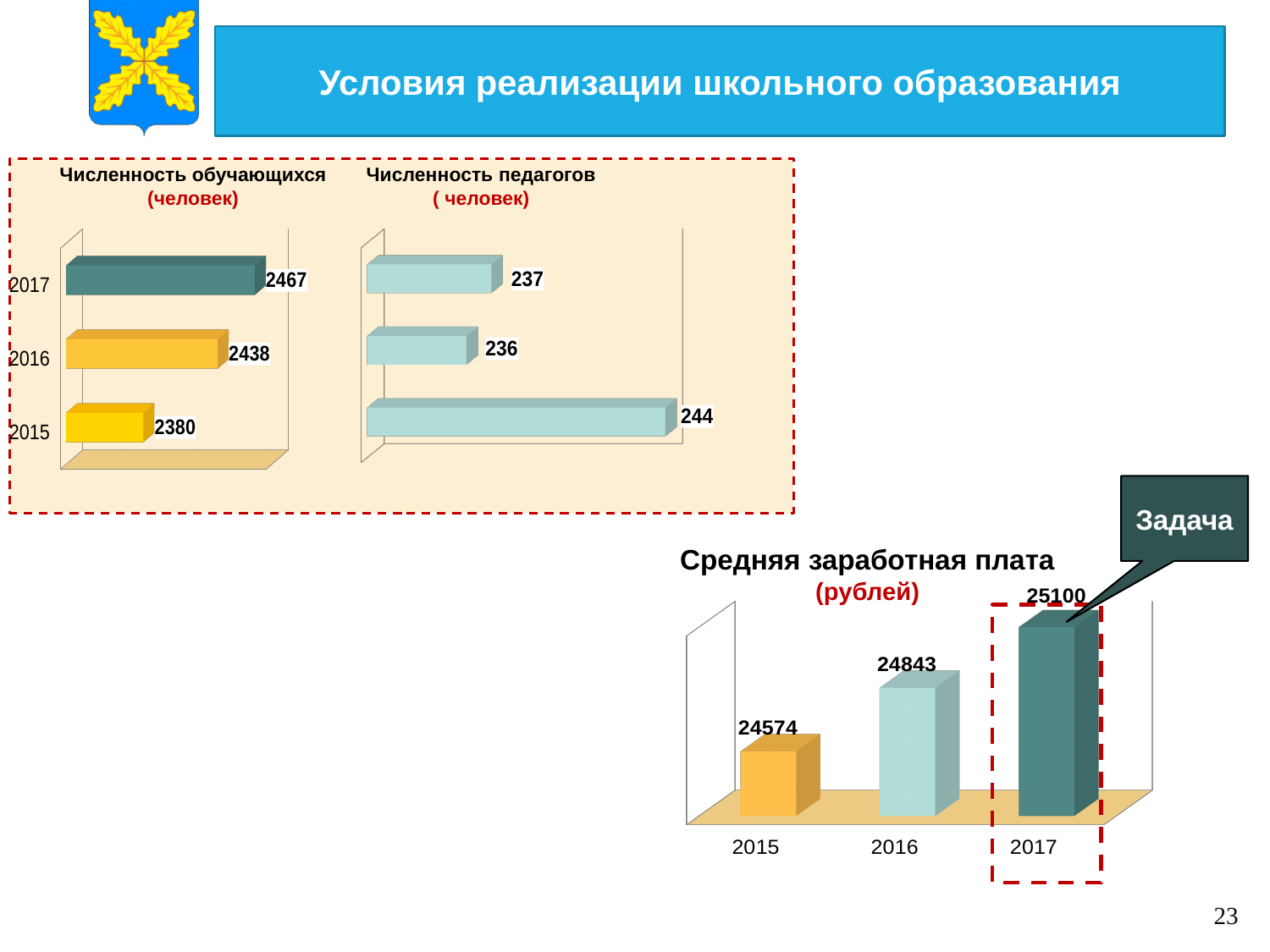
In the chart 'Численность обучающихся (человек)', what is the value for 2017? 2467 In the chart 'Численность педагогов (человек)', what is the value of the shortest bar? 236 In the chart 'Средняя заработная плата (рублей)', what is the difference between the 2017 and 2015 values? 526 In the chart 'Средняя заработная плата (рублей)', what is the value for 2016? 24843 In the chart 'Численность педагогов (человек)', what is the value of the longest bar? 244 In the chart 'Средняя заработная плата (рублей)', which year has the highest value? 2017 In the chart 'Численность обучающихся (человек)', do the values rise or fall from 2015 to 2017? rise What kind of chart is 'Средняя заработная плата (рублей)'? bar chart In the chart 'Численность обучающихся (человек)', what is the difference between the 2017 and 2016 values? 29 In the chart 'Численность обучающихся (человек)', which year has the lowest value? 2015 In the chart 'Численность обучающихся (человек)', what is the value for 2015? 2380 In the chart 'Численность педагогов (человек)', how many bars are shown? 3